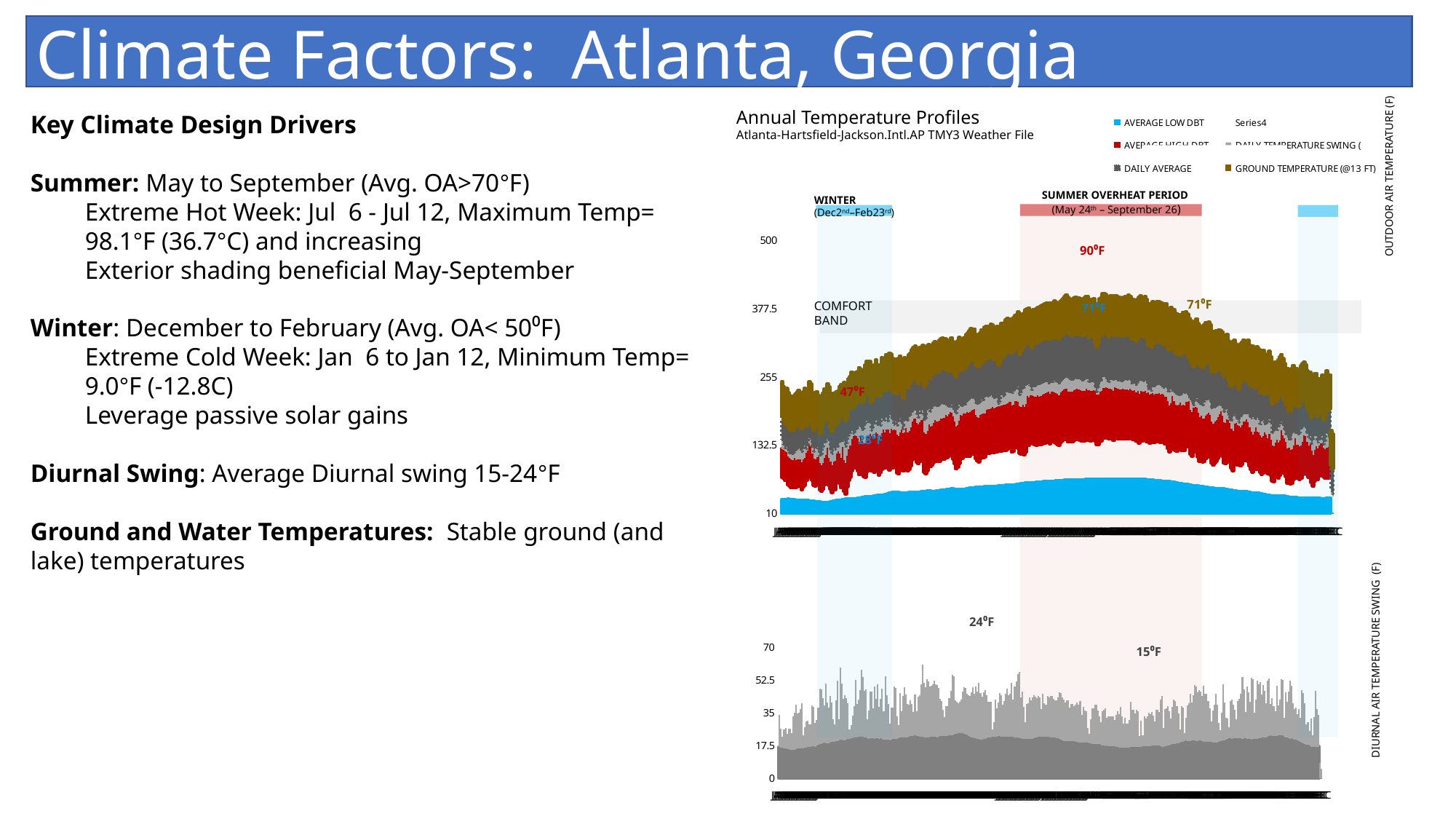
What kind of chart is the Annual Temperature Profiles chart? Area chart In the lower diurnal swing panel of the chart, what swing value is annotated in the winter portion? 24⁰F In the Annual Temperature Profiles chart, what temperature is annotated in red near the Winter period? 47⁰F In the lower diurnal swing panel, what is the difference between the annotated winter swing (24⁰F) and the annotated summer swing (15⁰F)? 9⁰F In the Annual Temperature Profiles chart, what temperature is annotated in red within the Summer Overheat Period? 90⁰F What is the highest tick value shown on the y-axis of the lower diurnal swing panel? 70 What date range does the chart label for the Summer Overheat Period? May 24th – September 26 What is the title of the chart on the right side of the slide? Annual Temperature Profiles In the Annual Temperature Profiles chart, which annotated red temperature is larger: the summer value or the winter value? Summer (90⁰F) In the Annual Temperature Profiles chart, what ground temperature value is annotated in gold on the right side of the summer peak? 71⁰F How many entries does the legend of the Annual Temperature Profiles chart list? 6 In the lower diurnal swing panel of the chart, what swing value is annotated within the Summer Overheat Period? 15⁰F